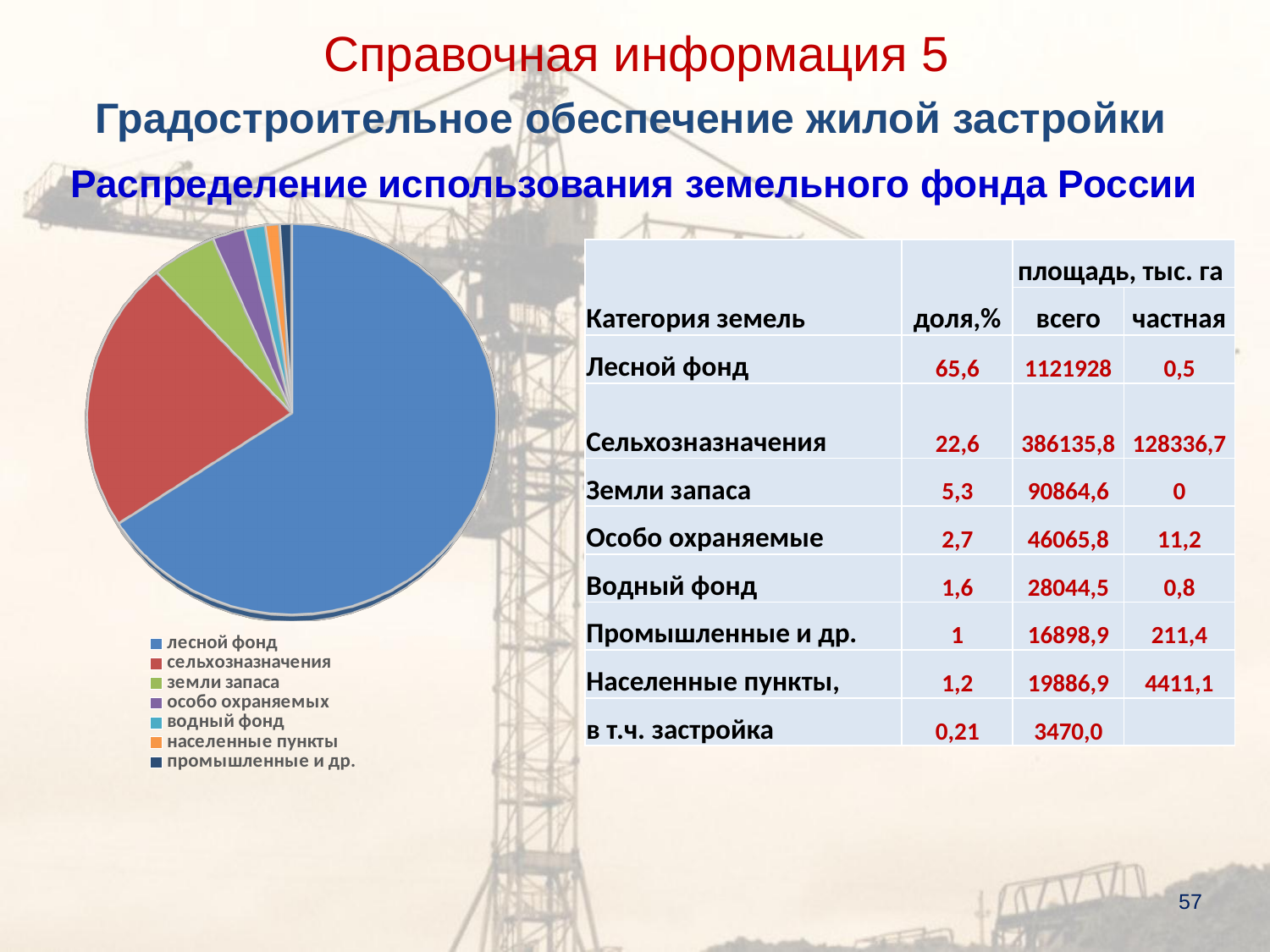
Does the лесной фонд slice take up more or less than half of the pie chart? more Which category has the largest slice in the pie chart? лесной фонд What kind of chart is shown on the slide? pie chart Which legend entry is listed first in the pie chart's legend? лесной фонд Which slice is larger in the pie chart: сельхозназначения or земли запаса? сельхозназначения How many categories does the pie chart's legend list? 7 What colour is the лесной фонд slice in the pie chart? blue According to the slide, what share (доля, %) of the land fund does сельхозназначения represent? 22,6 Which slice is larger in the pie chart: земли запаса or водный фонд? земли запаса Which slice is larger in the pie chart: лесной фонд or сельхозназначения? лесной фонд According to the slide, what share (доля, %) of the land fund does лесной фонд represent? 65,6